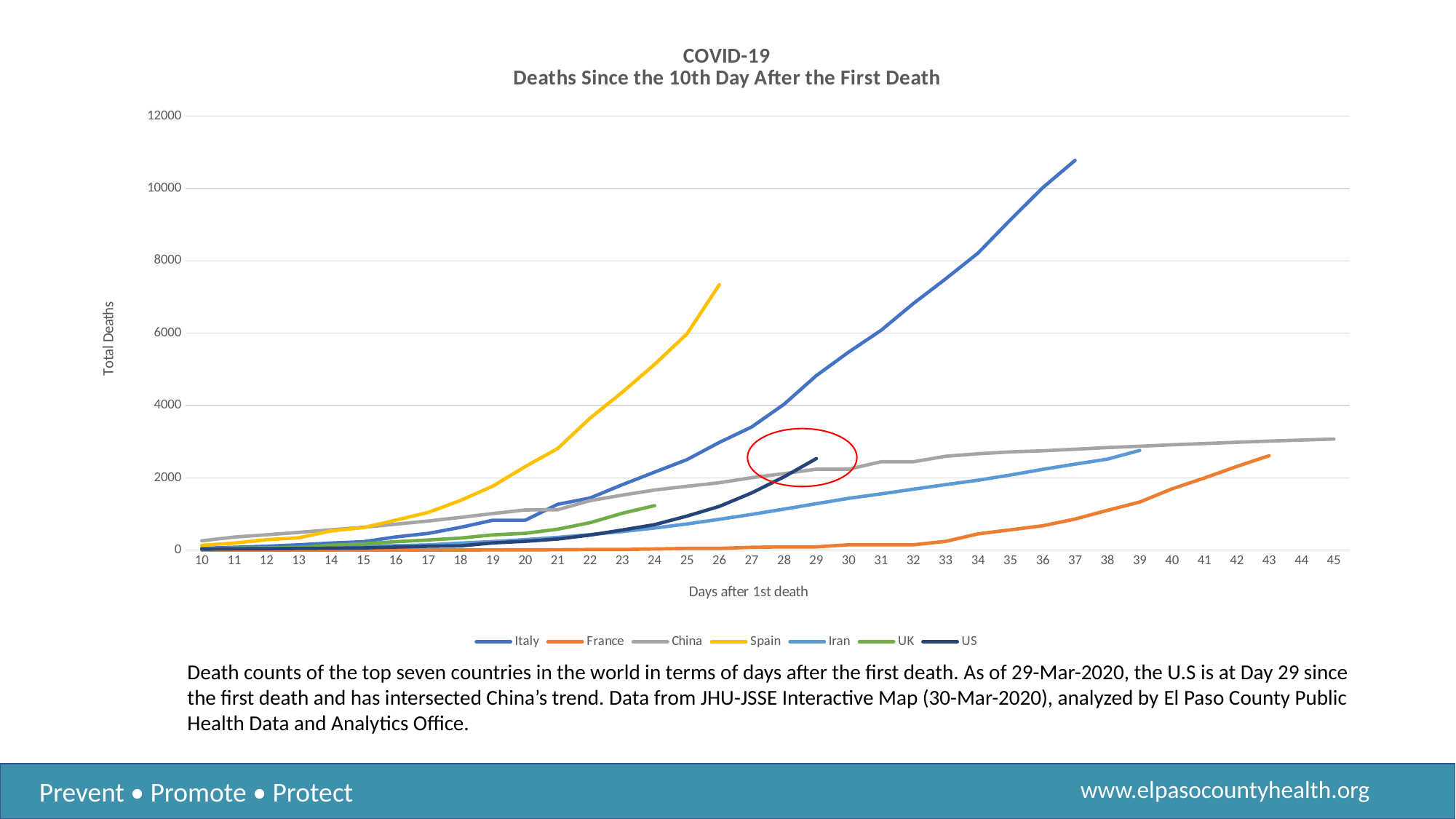
Which series reaches the highest total deaths on the chart? Italy Does the Italy line rise or fall as the days after the first death increase? rise Which series extends to the latest day on the x axis? China Is the value for China at day 45 greater or less than 4000? less Is the value for Spain at day 26 greater or less than 6000? greater Is the value for Italy at day 37 greater or less than 10000? greater What kind of chart is shown on the slide? line chart What is the label of the y axis? Total Deaths How many series does the legend list? 7 Which is larger at day 26: the value for Spain or the value for China? Spain